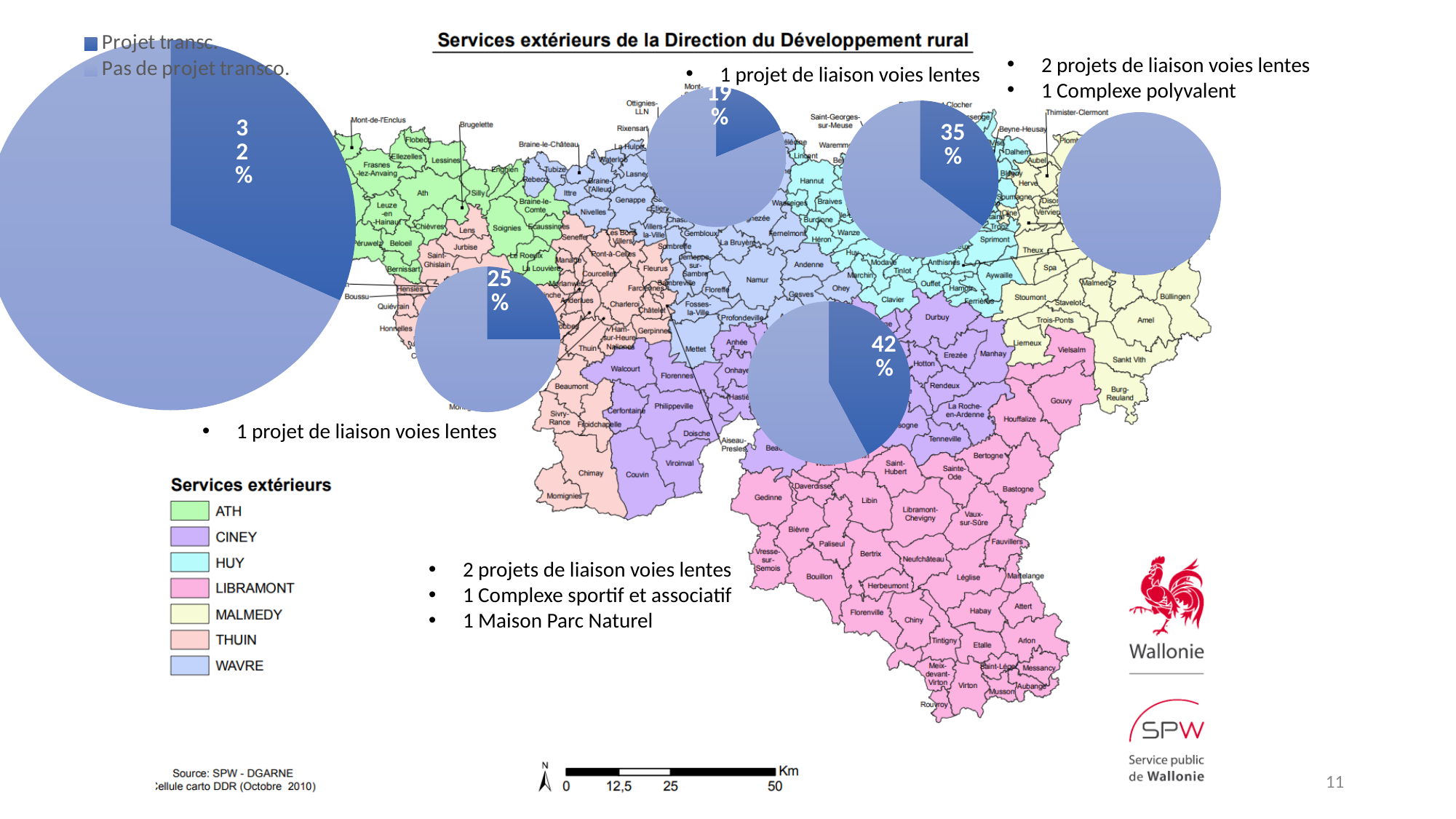
Among the labelled pie charts on the slide, which one shows the lowest percentage? The pie over the Wavre area (19%) How many entries does the pie chart legend at the top left of the slide list? 2 In the pie chart over the Wavre area (top centre of the map), what percentage is printed on the dark blue slice? 19% What is the difference between the percentage on the pie over the Ciney area and the percentage on the pie over the Wavre area? 23% In the pie chart over the Huy area (top right-centre of the map), what percentage is printed on the dark blue slice? 35% In the pie chart over the Thuin area (left-centre of the map), what percentage is printed on the dark blue slice? 25% In the pie chart legend at the top left of the slide, what label is given to the dark blue colour? Projet transc. What kind of charts are overlaid on the map of the slide? Pie charts Among the labelled pie charts on the slide, which one shows the highest percentage? The pie over the Ciney area (42%) Which is larger: the percentage on the pie over the Huy area or the percentage on the pie over the Thuin area? Huy area (35%)